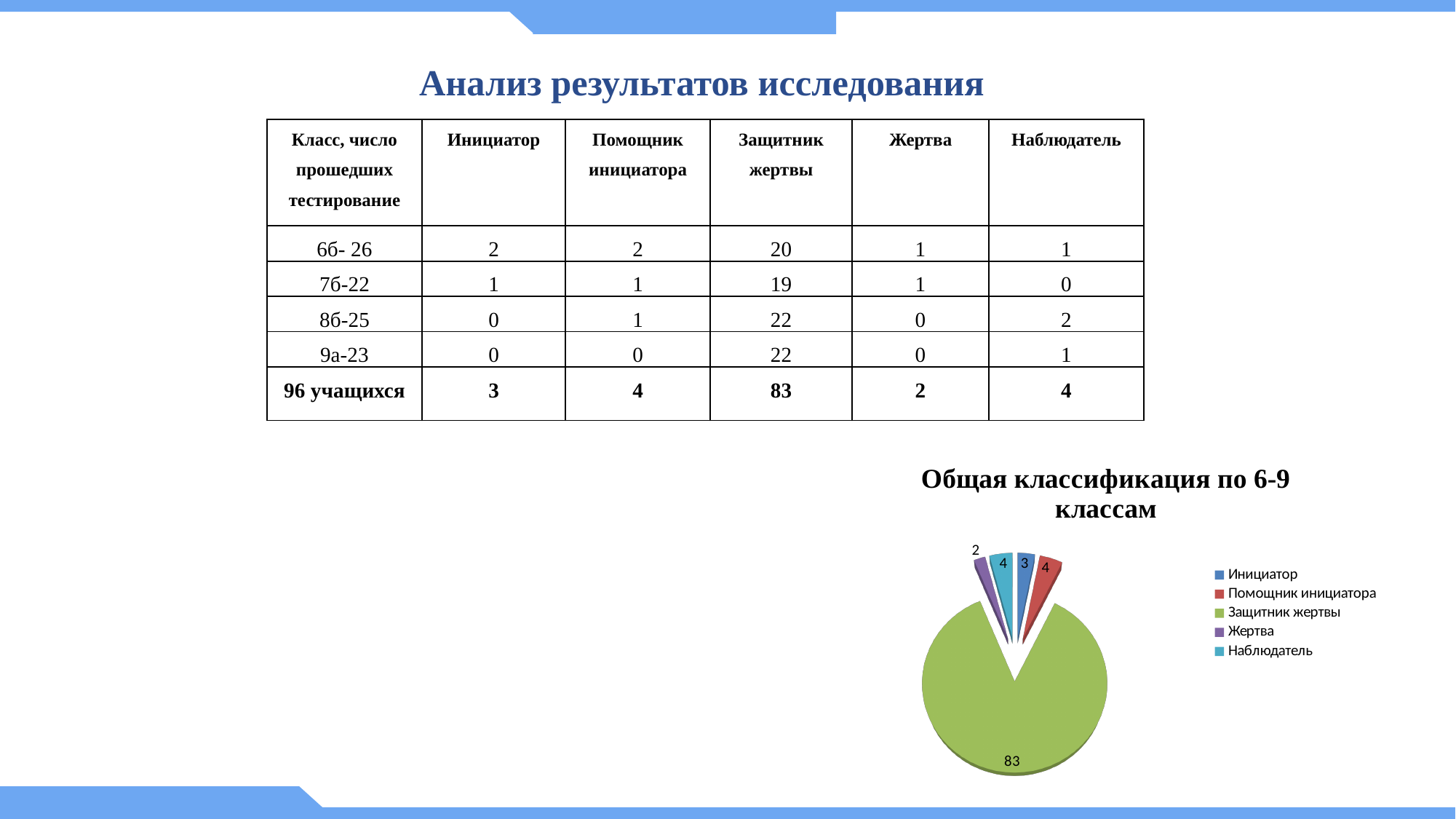
In the pie chart, what is the value for Жертва? 2 What is the title of the pie chart? Общая классификация по 6-9 классам Which category has the largest slice in the pie chart? Защитник жертвы What kind of chart is shown on the slide? pie chart In the pie chart, what is the difference between the values for Защитник жертвы and Помощник инициатора? 79 In the pie chart, what is the value for Защитник жертвы? 83 In the pie chart, what is the value for Наблюдатель? 4 How many slices does the pie chart have? 5 Which category has the smallest slice in the pie chart? Жертва In the pie chart, which is larger: Инициатор or Помощник инициатора? Помощник инициатора How many entries does the legend of the pie chart list? 5 In the pie chart, what is the value for Инициатор? 3